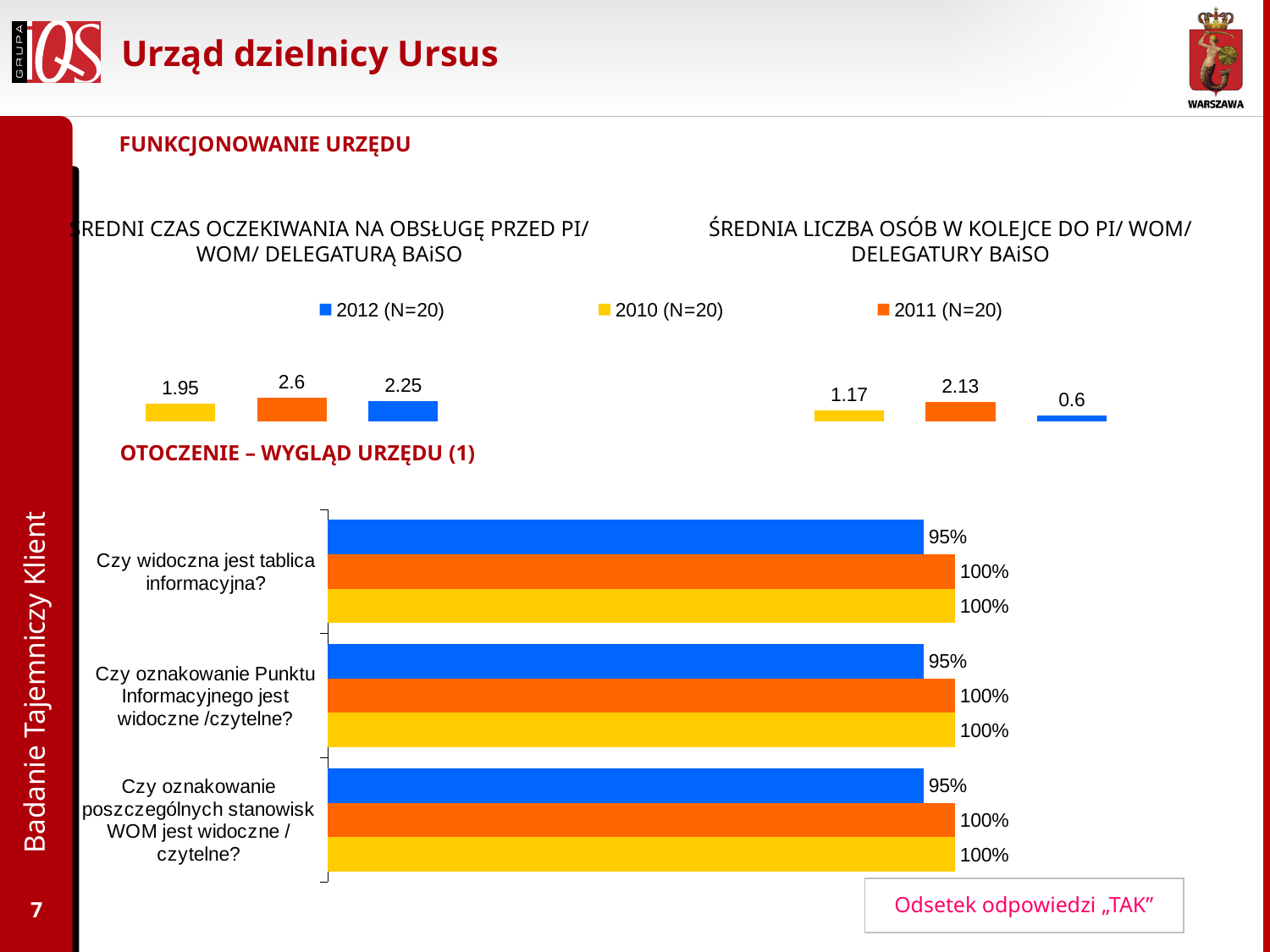
In the chart titled "ŚREDNIA LICZBA OSÓB W KOLEJCE DO PI/ WOM/ DELEGATURY BAiSO", which year has the lowest value? 2012 (N=20) How many series does the legend list for the top charts? 3 In the chart titled "ŚREDNI CZAS OCZEKIWANIA NA OBSŁUGĘ PRZED PI/ WOM/ DELEGATURĄ BAiSO", what is the value for 2011 (N=20)? 2.6 In the bottom chart under "OTOCZENIE – WYGLĄD URZĘDU (1)", what is the value of the orange bar for "Czy oznakowanie Punktu Informacyjnego jest widoczne /czytelne?"? 100% In the chart titled "ŚREDNIA LICZBA OSÓB W KOLEJCE DO PI/ WOM/ DELEGATURY BAiSO", what is the value for 2012 (N=20)? 0.6 In the chart titled "ŚREDNI CZAS OCZEKIWANIA NA OBSŁUGĘ PRZED PI/ WOM/ DELEGATURĄ BAiSO", which year has the highest value? 2011 (N=20) In the chart titled "ŚREDNIA LICZBA OSÓB W KOLEJCE DO PI/ WOM/ DELEGATURY BAiSO", what is the difference between the 2011 (N=20) and 2010 (N=20) values? 0.96 In the chart titled "ŚREDNI CZAS OCZEKIWANIA NA OBSŁUGĘ PRZED PI/ WOM/ DELEGATURĄ BAiSO", which is larger: the value for 2012 (N=20) or for 2010 (N=20)? 2012 (N=20) In the chart titled "ŚREDNI CZAS OCZEKIWANIA NA OBSŁUGĘ PRZED PI/ WOM/ DELEGATURĄ BAiSO", what is the value for 2010 (N=20)? 1.95 In the bottom chart under "OTOCZENIE – WYGLĄD URZĘDU (1)", what is the value of the blue bar for "Czy widoczna jest tablica informacyjna?"? 95% What kind of chart is the bottom chart under "OTOCZENIE – WYGLĄD URZĘDU (1)"? Bar chart How many categories are shown in the bottom chart under "OTOCZENIE – WYGLĄD URZĘDU (1)"? 3